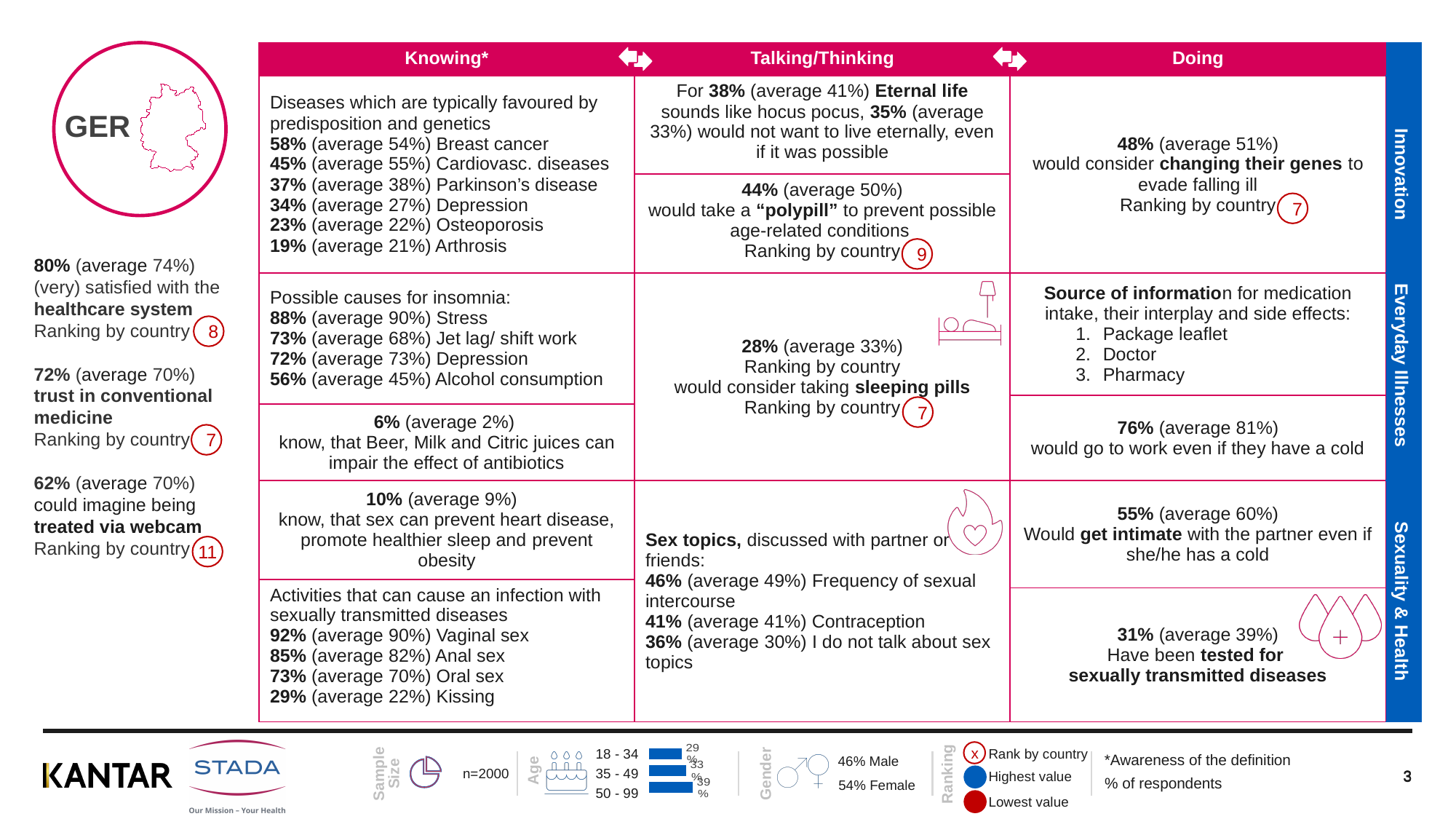
In the Age bar chart at the bottom of the slide, which age group has the highest value? 50 - 99 In the Age bar chart at the bottom of the slide, what is the difference between the 35 - 49 and 18 - 34 values? 4% In the Age bar chart at the bottom of the slide, do the values rise or fall from the 18 - 34 group to the 50 - 99 group? Rise In the Age bar chart at the bottom of the slide, what is the value for the 18 - 34 age group? 29% What is the total of the three values in the Age bar chart at the bottom of the slide? 101% In the Age bar chart at the bottom of the slide, what is the value for the 35 - 49 age group? 33% In the Age bar chart at the bottom of the slide, which is larger: the value for 35 - 49 or the value for 50 - 99? 50 - 99 In the Age bar chart at the bottom of the slide, what is the difference between the 50 - 99 and 18 - 34 values? 10% In the Age bar chart at the bottom of the slide, which age group has the lowest value? 18 - 34 In the Age bar chart at the bottom of the slide, what is the value for the 50 - 99 age group? 39% How many age groups are shown in the Age bar chart at the bottom of the slide? 3 What kind of chart is the Age chart at the bottom of the slide? Bar chart